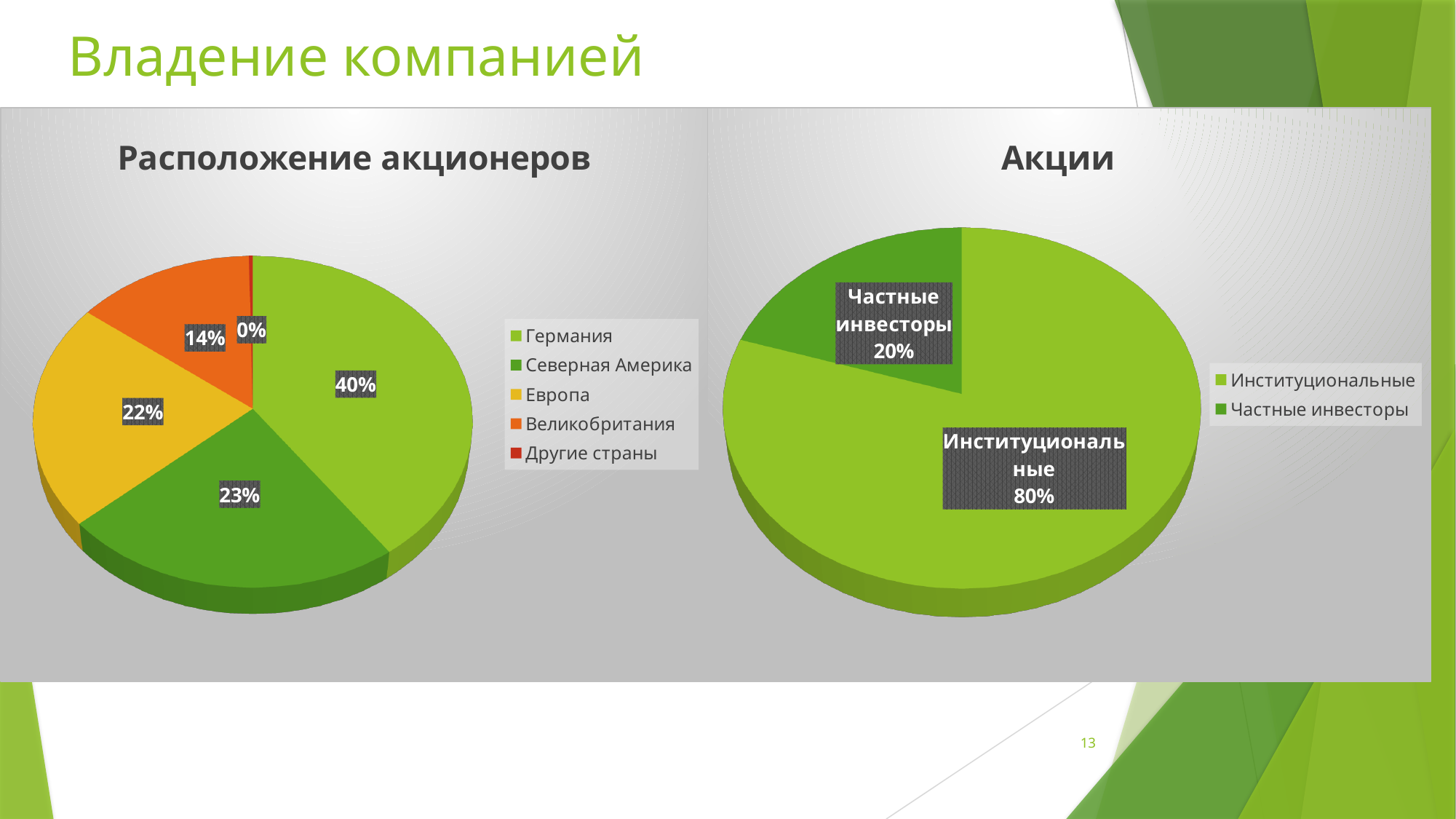
In the 'Расположение акционеров' chart, which category has the largest share? Германия In the 'Расположение акционеров' chart, which category has the smallest share? Другие страны In the 'Расположение акционеров' chart, what is the difference between the shares of Германия and Северная Америка? 17% In the 'Акции' chart, what is the difference between the shares of Институциональные and Частные инвесторы? 60% What type of chart is the 'Акции' chart? Pie chart How many categories does the legend of the 'Расположение акционеров' chart list? 5 In the 'Акции' chart, what share do Частные инвесторы hold? 20% In the 'Расположение акционеров' chart, which is larger: the share of Европа or the share of Великобритания? Европа In the 'Расположение акционеров' chart, what share does Европа hold? 22% In the 'Расположение акционеров' chart, what share does Германия hold? 40% In the 'Расположение акционеров' chart, what share does Великобритания hold? 14% What is the title of the chart on the left side of the slide? Расположение акционеров